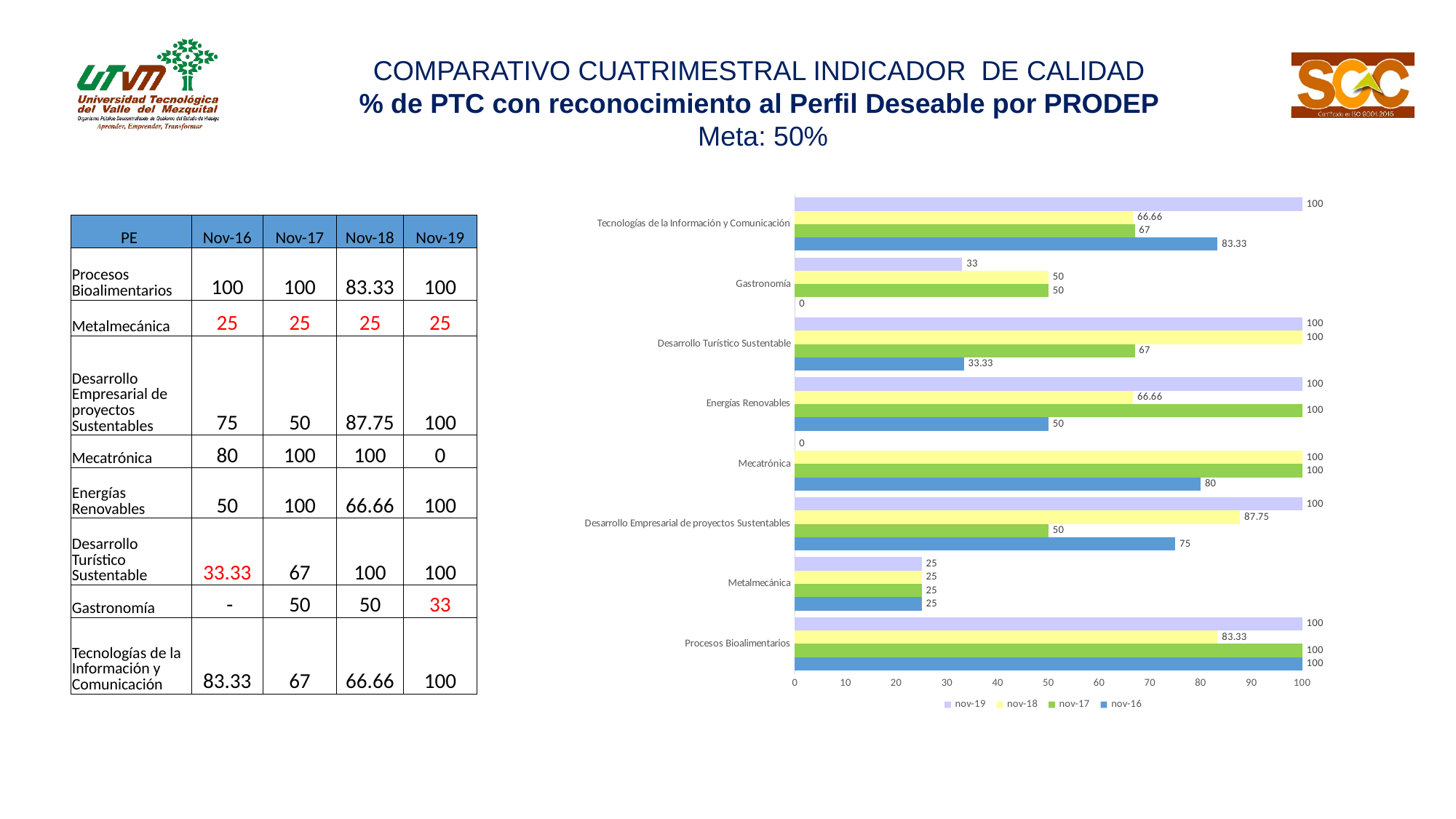
Is the nov-16 value for Mecatrónica greater or less than 50? greater What is the nov-19 value for Gastronomía in the chart? 33 Which series is shown in the lightest (lavender) colour in the chart legend? nov-19 How many series does the chart legend list? 4 Which category has the lowest nov-19 value in the chart? Mecatrónica Which is larger for Energías Renovables: the nov-17 value or the nov-18 value? nov-17 What is the nov-19 value for Mecatrónica in the chart? 0 What is the nov-16 value for Tecnologías de la Información y Comunicación in the chart? 83.33 What is the nov-18 value for Desarrollo Empresarial de proyectos Sustentables in the chart? 87.75 What type of chart is shown on the slide? bar chart How many categories (programs) are plotted on the chart? 8 What is the difference between the nov-19 and nov-16 values for Desarrollo Turístico Sustentable? 66.67